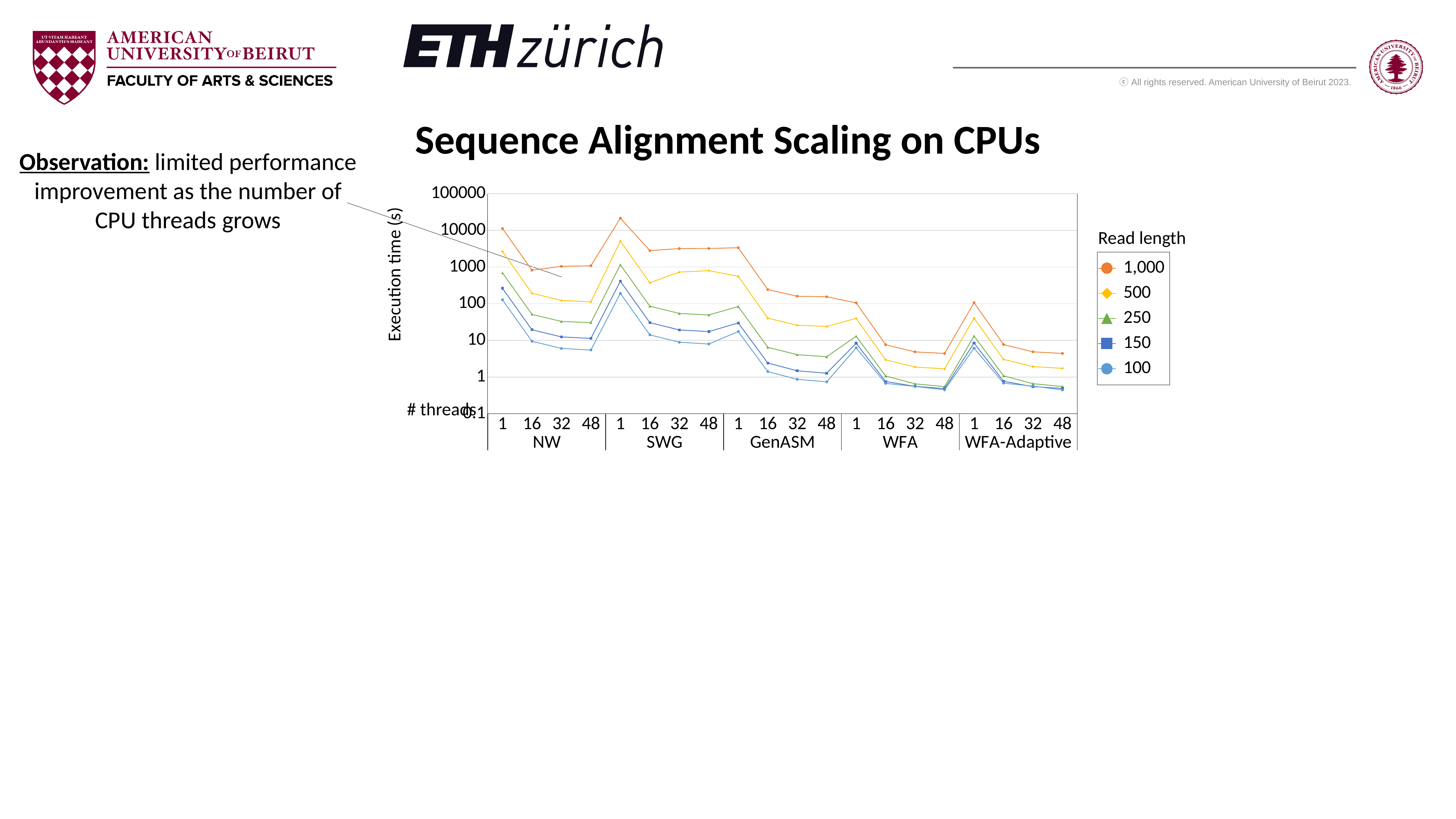
Is the execution time for read length 100 at 48 threads for NW greater or less than 10? less How many series does the legend list? 5 Which thread counts are shown for each algorithm on the x axis? 1, 16, 32, 48 What is the label of the y axis? Execution time (s) Is the execution time for read length 1,000 at 1 thread for GenASM greater or less than 1000? greater Which algorithm has the highest execution time at 1 thread for read length 1,000? SWG Within each algorithm, does execution time rise or fall as the number of threads increases from 1 to 48? fall How many alignment algorithms are shown along the x axis? 5 Is the execution time for read length 1,000 at 1 thread for SWG greater or less than 10000? greater What is the title of the chart? Sequence Alignment Scaling on CPUs What kind of chart is shown on the slide? Line chart Which read length series has the lowest execution times across the chart? 100